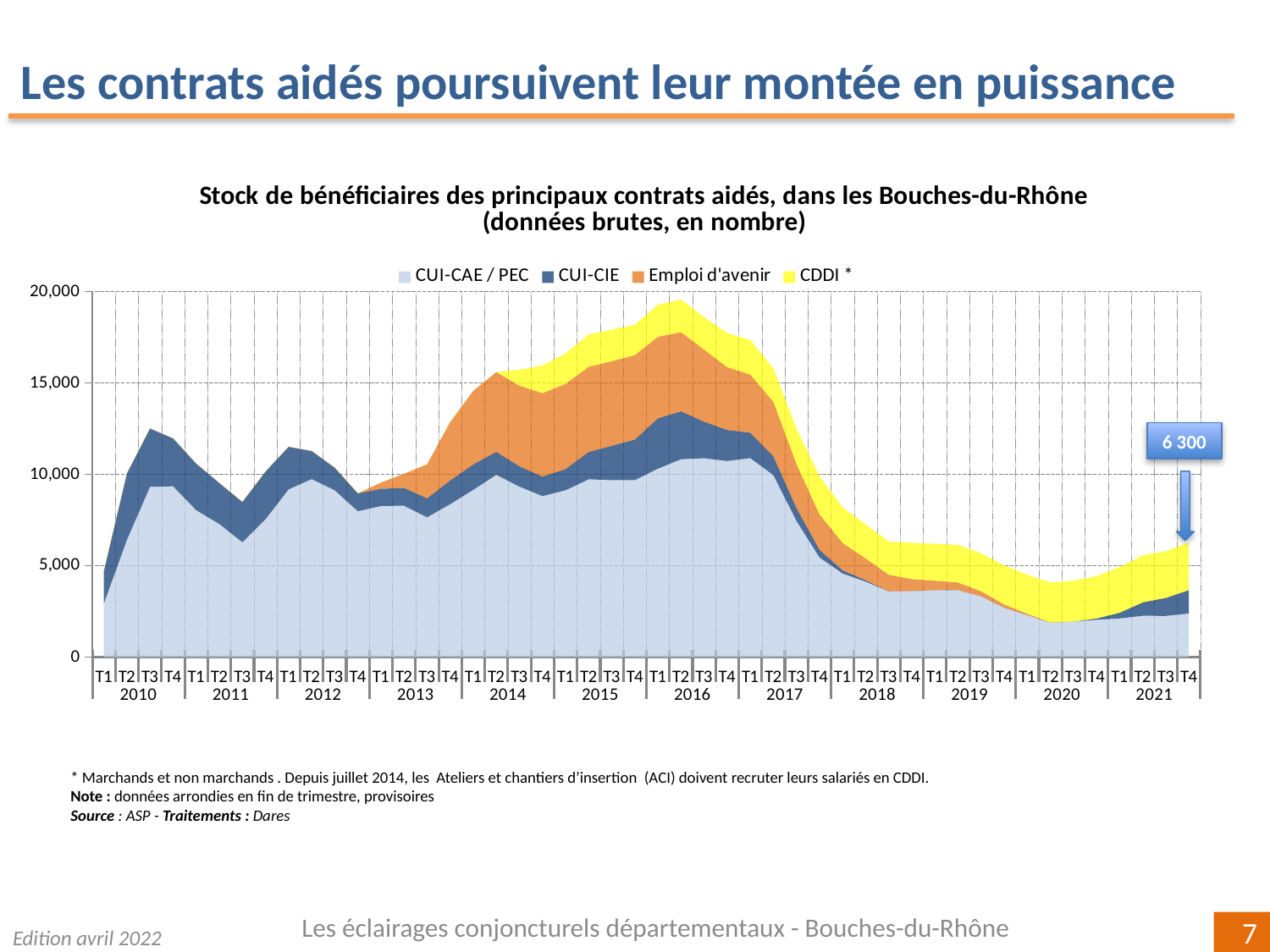
In which year does the total stock of beneficiaries reach its highest level? 2016 What value is shown in the annotation pointing to T4 2021? 6 300 How many series does the legend list? 4 Which series forms the bottom layer of the stacked area? CUI-CAE / PEC Does the total stock of beneficiaries rise or fall between 2016 and 2020? Fall Which series is shown in yellow? CDDI * What kind of chart is shown on the slide? Stacked area chart Does the total stock of beneficiaries rise or fall between T2 2020 and T4 2021? Rise Is the total stock of beneficiaries in T1 2018 greater or less than 5,000? greater Is the total stock of beneficiaries in T2 2020 greater or less than 5,000? less How many years are shown along the x axis? 12 Is the total stock of beneficiaries in T2 2016 greater or less than 15,000? greater